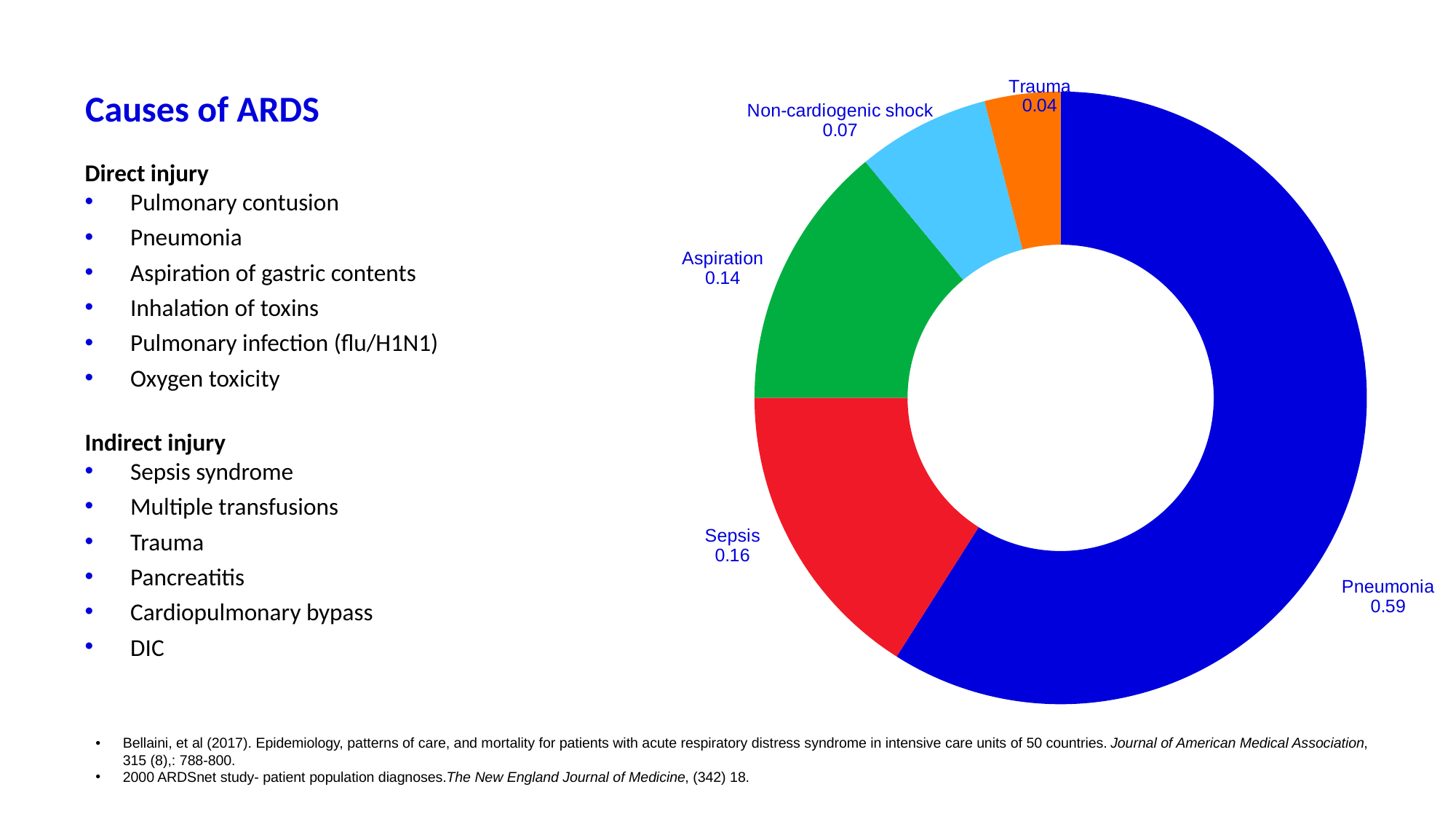
What is the value shown for Sepsis in the donut chart? 0.16 What kind of chart is shown on the slide? Donut (pie) chart What colour is the Sepsis slice in the donut chart? Red Which is larger, the value for Aspiration or the value for Non-cardiogenic shock? Aspiration What is the value shown for Pneumonia in the donut chart? 0.59 What is the difference between the values for Pneumonia and Sepsis? 0.43 Which cause has the smallest slice in the donut chart? Trauma How many causes are shown as slices in the donut chart? 5 What is the value shown for Aspiration in the donut chart? 0.14 What is the value shown for Non-cardiogenic shock in the donut chart? 0.07 Which cause has the largest slice in the donut chart? Pneumonia What is the value shown for Trauma in the donut chart? 0.04